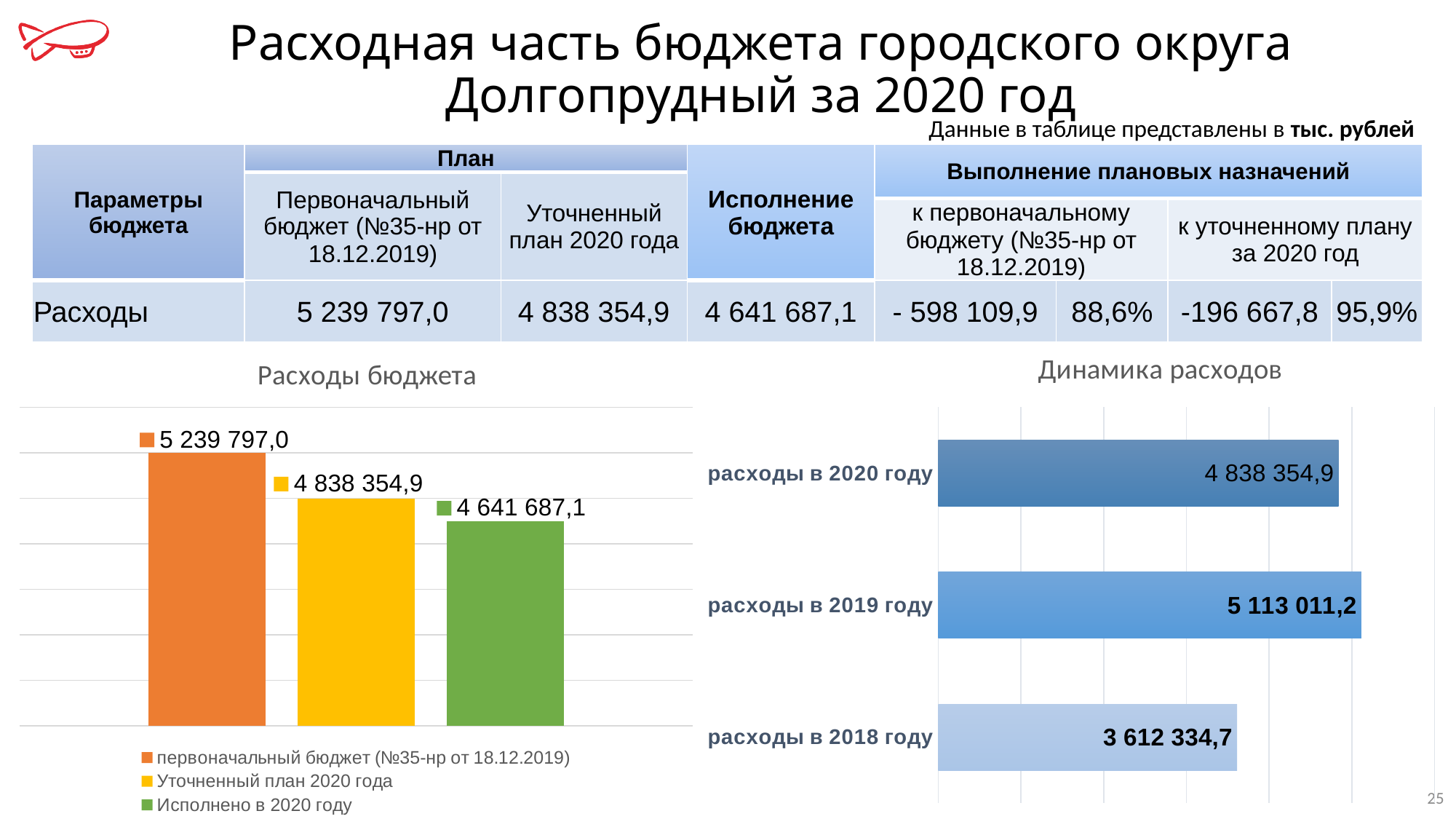
In the "Расходы бюджета" chart, which series has the highest value? первоначальный бюджет (№35-нр от 18.12.2019) In the "Динамика расходов" chart, what is the value for "расходы в 2019 году"? 5 113 011,2 In the "Расходы бюджета" chart, what is the value for "Уточненный план 2020 года"? 4 838 354,9 In the "Динамика расходов" chart, which is larger: "расходы в 2020 году" or "расходы в 2019 году"? расходы в 2019 году In the "Динамика расходов" chart, how many categories are plotted? 3 In the "Расходы бюджета" chart, what is the difference between "Уточненный план 2020 года" and "Исполнено в 2020 году"? 196 667,8 In the "Расходы бюджета" chart, what is the value for "Исполнено в 2020 году"? 4 641 687,1 In the "Динамика расходов" chart, what is the value for "расходы в 2018 году"? 3 612 334,7 In the "Расходы бюджета" chart, how many series does the legend list? 3 What kind of chart is "Динамика расходов"? Bar chart In the "Расходы бюджета" chart, what colour is the bar for "Уточненный план 2020 года"? Yellow In the "Динамика расходов" chart, which category has the lowest value? расходы в 2018 году